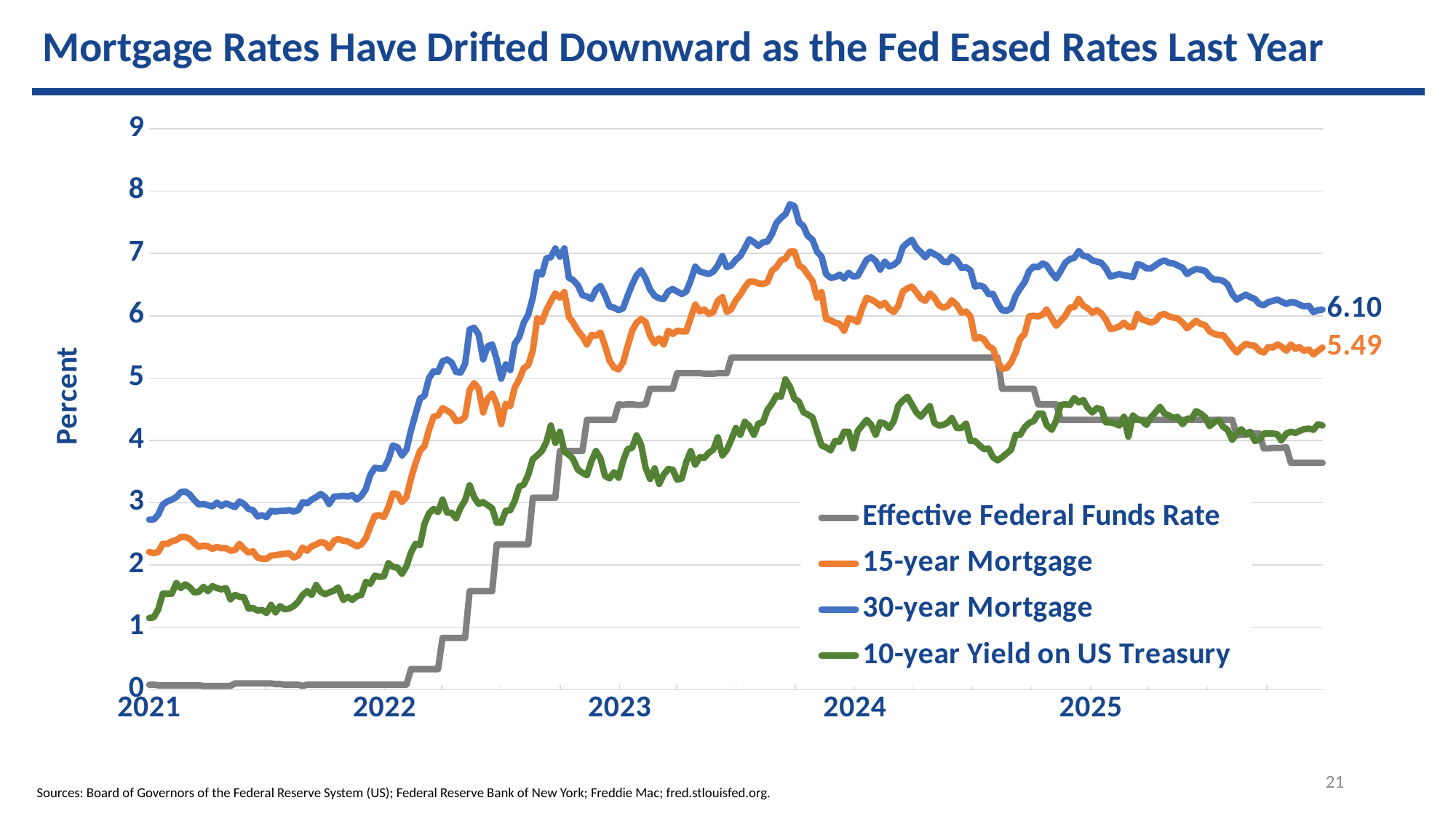
Which series has the lowest value at the right end of the chart? Effective Federal Funds Rate Is the Effective Federal Funds Rate at the start of 2021 greater or less than 1? less What is the difference between the labeled end values of the 30-year Mortgage and the 15-year Mortgage? 0.61 What is the latest value shown for the 30-year Mortgage series? 6.10 At the end of the chart, which is larger: the 30-year Mortgage rate or the 15-year Mortgage rate? 30-year Mortgage What is the label on the vertical axis? Percent Did the 30-year Mortgage rate rise or fall between the start of 2021 and the start of 2023? Rise What kind of chart is shown on the slide? Line chart How many series does the legend list? 4 What is the latest value shown for the 15-year Mortgage series? 5.49 Which series has the highest value at the right end of the chart? 30-year Mortgage Is the peak value of the 30-year Mortgage series greater or less than 7? greater